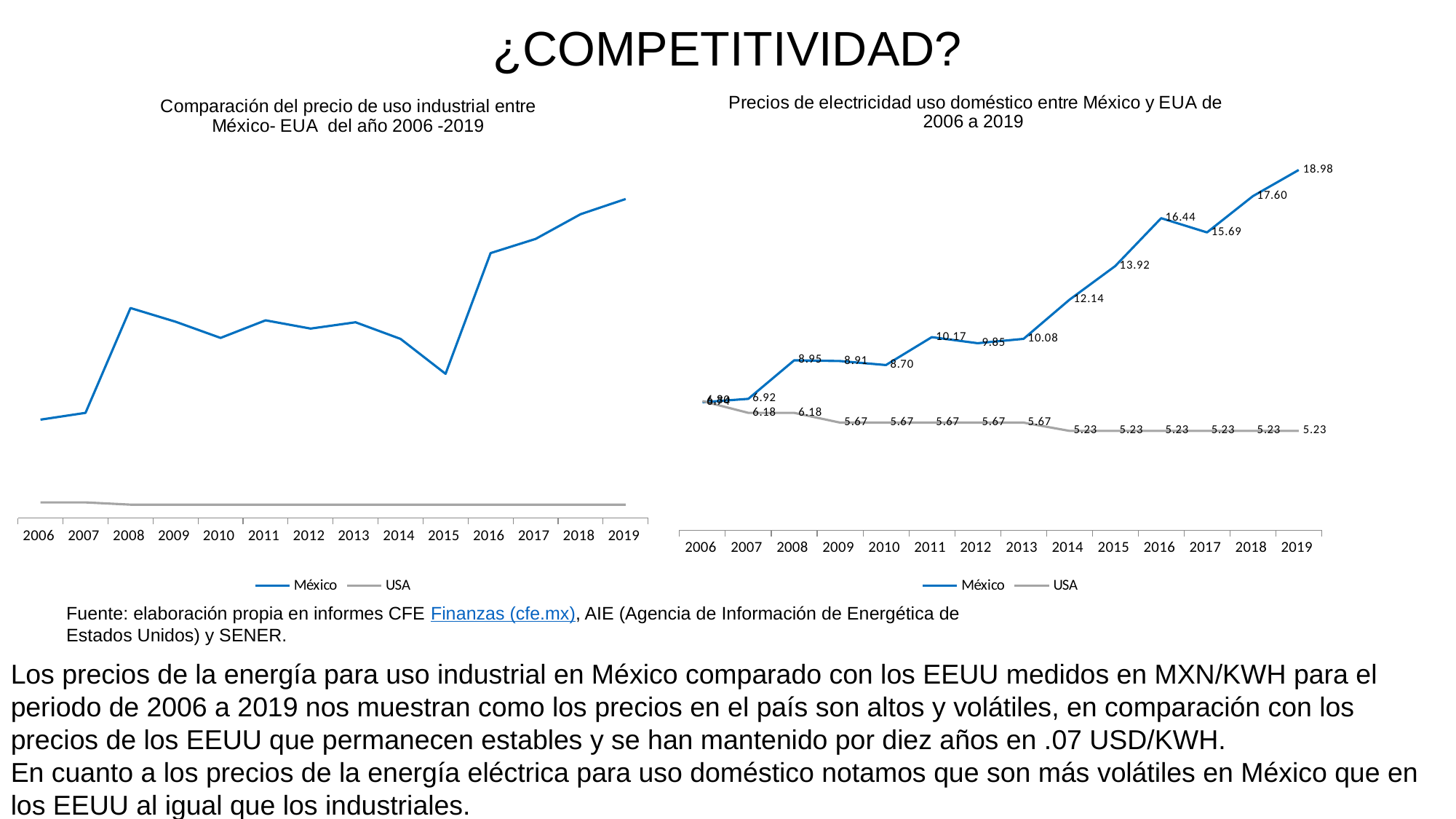
In the chart titled 'Precios de electricidad uso doméstico entre México y EUA de 2006 a 2019', which is larger, the México value in 2016 or the México value in 2017? 2016 What kind of chart is the chart titled 'Comparación del precio de uso industrial entre México- EUA del año 2006 -2019'? line chart In the chart titled 'Precios de electricidad uso doméstico entre México y EUA de 2006 a 2019', in which year is the México value highest? 2019 How many series does the legend list in the chart titled 'Comparación del precio de uso industrial entre México- EUA del año 2006 -2019'? 2 How many years are shown on the x axis of the chart titled 'Comparación del precio de uso industrial entre México- EUA del año 2006 -2019'? 14 In the chart titled 'Precios de electricidad uso doméstico entre México y EUA de 2006 a 2019', what is the value for México in 2019? 18.98 In the chart titled 'Precios de electricidad uso doméstico entre México y EUA de 2006 a 2019', what is the difference between the México value in 2019 and the USA value in 2019? 13.75 In the chart titled 'Precios de electricidad uso doméstico entre México y EUA de 2006 a 2019', what is the value for México in 2015? 13.92 In the chart titled 'Precios de electricidad uso doméstico entre México y EUA de 2006 a 2019', what is the value for USA in 2012? 5.67 In the chart titled 'Precios de electricidad uso doméstico entre México y EUA de 2006 a 2019', does the USA series rise or fall from 2007 to 2019? fall In the chart titled 'Comparación del precio de uso industrial entre México- EUA del año 2006 -2019', in which year is the México value lowest? 2006 In the chart titled 'Precios de electricidad uso doméstico entre México y EUA de 2006 a 2019', what is the difference between the México values in 2016 and 2017? 0.75